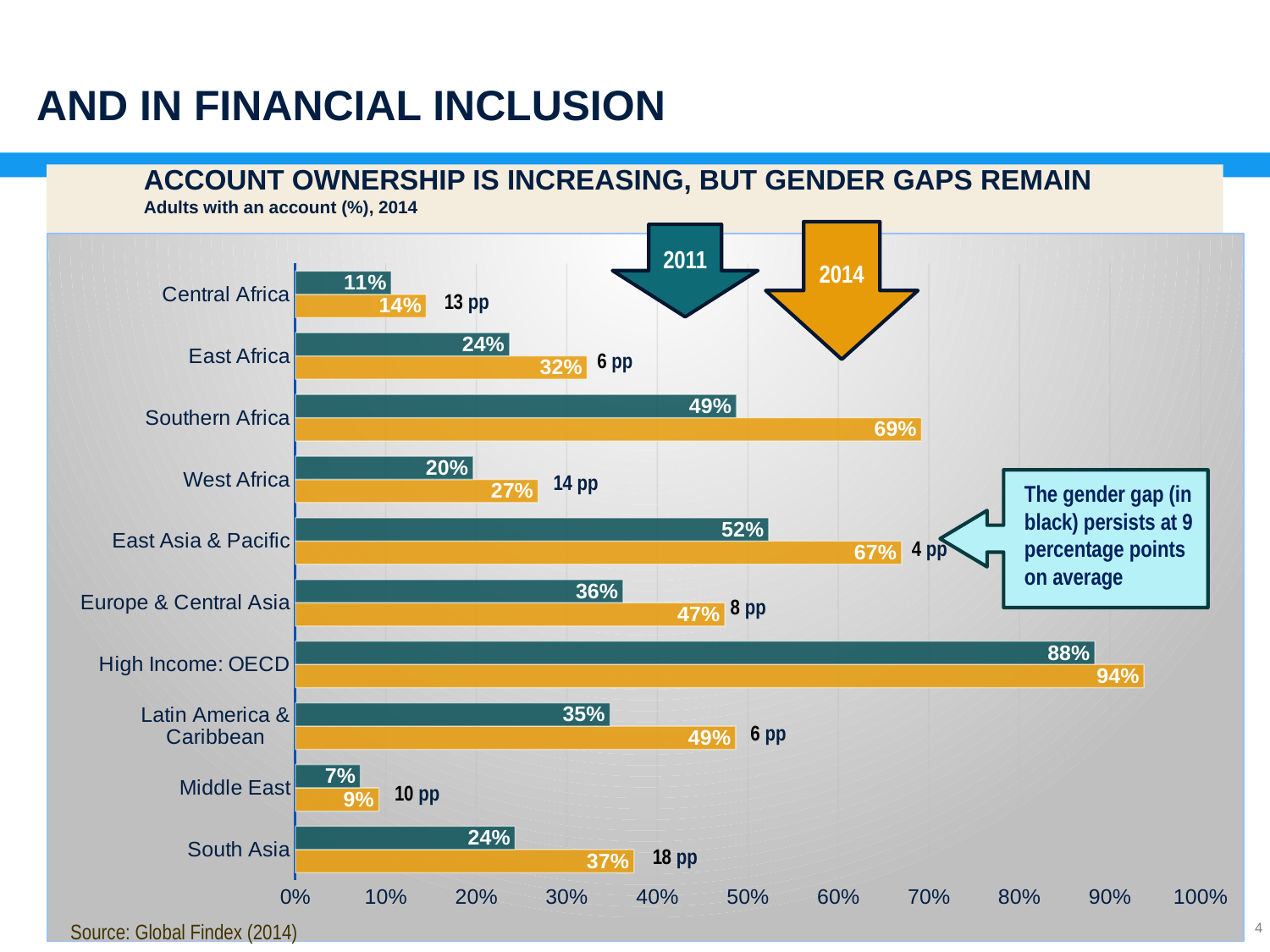
What type of chart is shown on the slide? Bar chart Which region had the lowest share of adults with an account in 2011? Middle East Is the 2014 value for Europe & Central Asia greater or less than 40%? greater What was the share of adults with an account in the Middle East in 2011? 7% Which colour represents the 2014 values on the chart? Orange Which region had a higher share of adults with an account in 2014: East Africa or West Africa? East Africa What was the share of adults with an account in Southern Africa in 2014? 69% How many years (series) does the chart compare? 2 How many regions are shown on the chart? 10 By how many percentage points did account ownership in South Asia increase from 2011 to 2014? 13 Which region had the highest share of adults with an account in 2014? High Income: OECD What gender gap in percentage points is labelled next to the South Asia bars? 18 pp